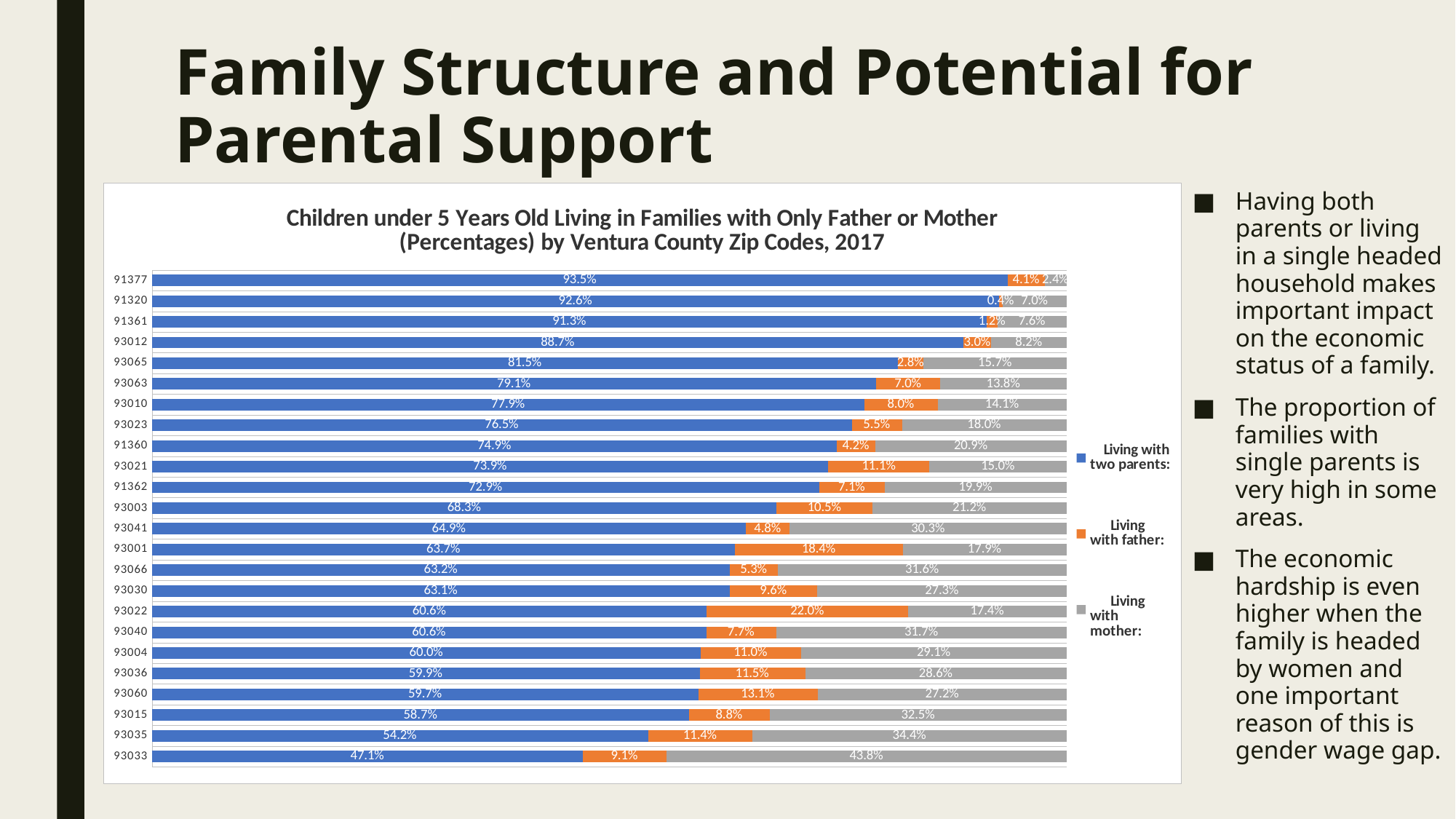
Which zip code has the highest percentage of children living with two parents? 91377 Which zip code has the highest percentage of children living with father? 93022 How many zip codes are shown in the chart? 24 Which zip code has a higher 'Living with two parents' percentage, 93065 or 93003? 93065 What is the difference between the 'Living with mother' percentages for 93033 and 91377? 41.4% Which zip code has the lowest percentage of children living with father? 91320 What percentage of children under 5 in zip code 93012 are living with two parents? 88.7% Which zip code has the lowest percentage of children living with two parents? 93033 What percentage of children under 5 in zip code 93041 are living with mother? 30.3% How many series does the legend list? 3 What type of chart is shown on the slide? Stacked bar chart What percentage of children under 5 in zip code 93001 are living with father? 18.4%